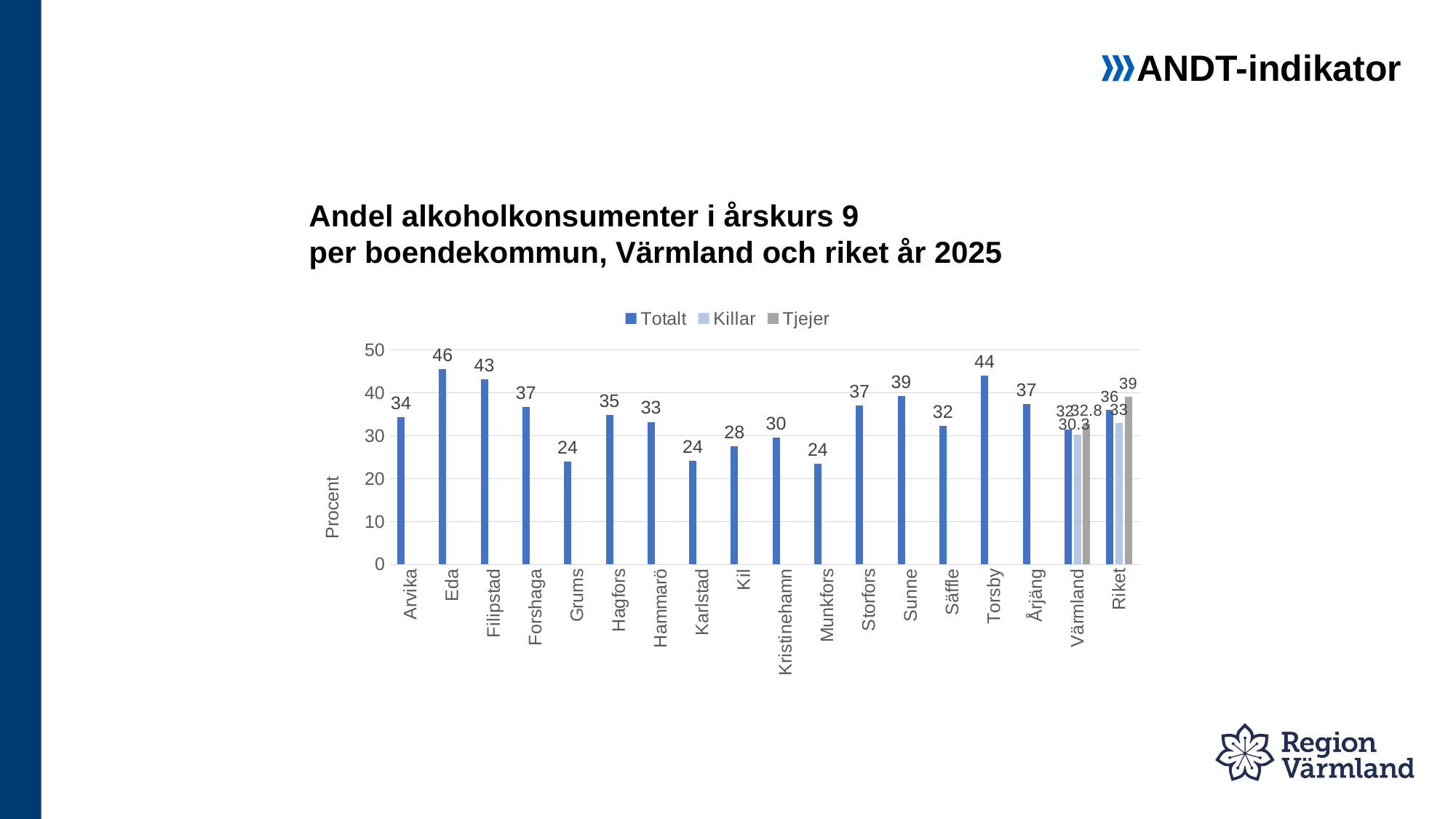
What is the difference between the Totalt values for Eda and Torsby? 2 What is the difference between the Tjejer and Killar values for Riket? 6 What is the Killar value for Riket? 33 How many series does the legend list? 3 What is the Totalt value for Kristinehamn? 30 What is the Tjejer value for Riket? 39 How many categories are shown on the x axis? 18 Which has a higher Totalt value, Filipstad or Sunne? Filipstad What is the label of the y axis? Procent What kind of chart is shown on the slide? Bar chart Which municipality has the highest Totalt value? Eda What is the Totalt value for Eda? 46